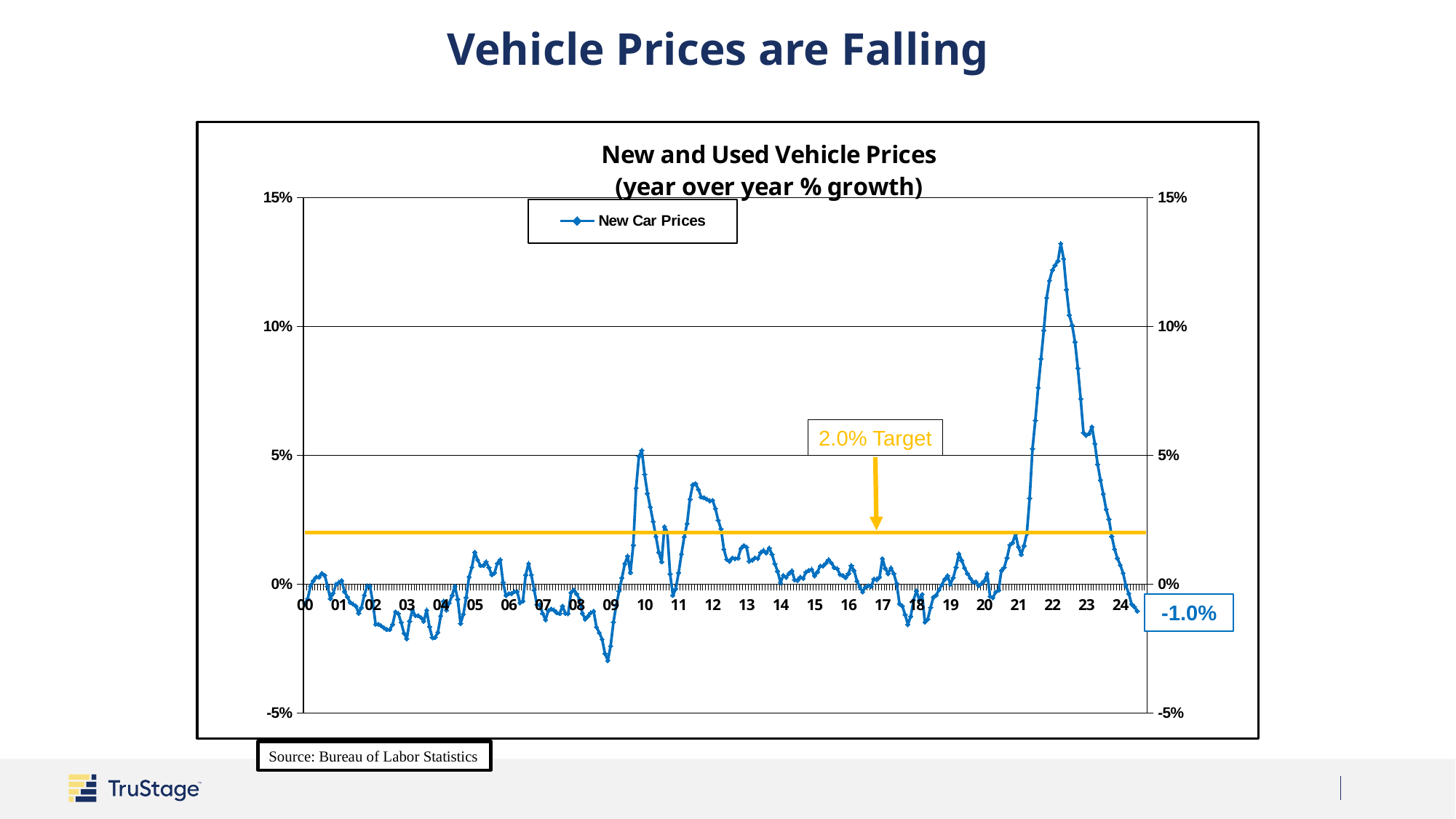
What kind of chart is shown on the slide? Line chart Is the lowest value for New Car Prices in 2009 greater or less than 0%? less Is the peak value for New Car Prices in 2022 greater or less than 10%? greater What target level is marked by the horizontal line on the chart? 2.0% Target How many year labels are shown on the x axis? 25 Which is larger: the peak of New Car Prices around 2010 or the peak around 2022? 2022 What is the most recent value shown for New Car Prices on the chart? -1.0% What is the name of the series shown in the legend? New Car Prices Does New Car Prices growth rise or fall from 2022 to 2024? Fall How many series does the legend list? 1 In which year does New Car Prices growth reach its highest point? 22 What is the title of the chart? New and Used Vehicle Prices (year over year % growth)